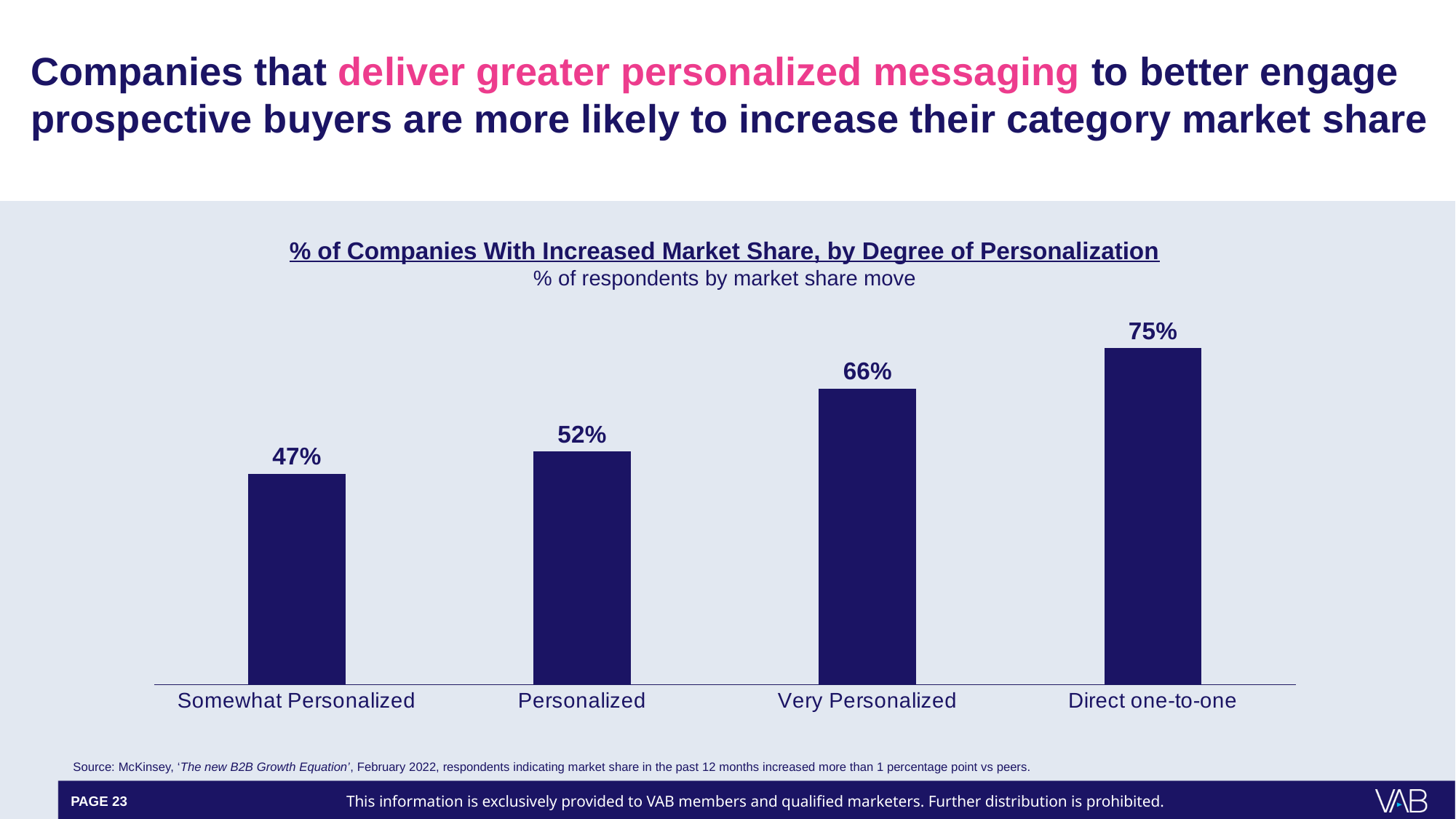
Which degree of personalization has the highest percentage of companies with increased market share? Direct one-to-one Do the values rise or fall from Somewhat Personalized to Direct one-to-one? Rise What is the value for Very Personalized? 66% What is the difference between the values for Direct one-to-one and Somewhat Personalized? 28 percentage points What is the value for Somewhat Personalized? 47% Which degree of personalization has the lowest percentage of companies with increased market share? Somewhat Personalized Which is larger, the value for Very Personalized or the value for Personalized? Very Personalized What is the value for Direct one-to-one? 75% What is the difference between the values for Very Personalized and Personalized? 14 percentage points What kind of chart is shown on the slide? Bar chart What is the value for Personalized? 52% How many categories are shown in the chart? 4